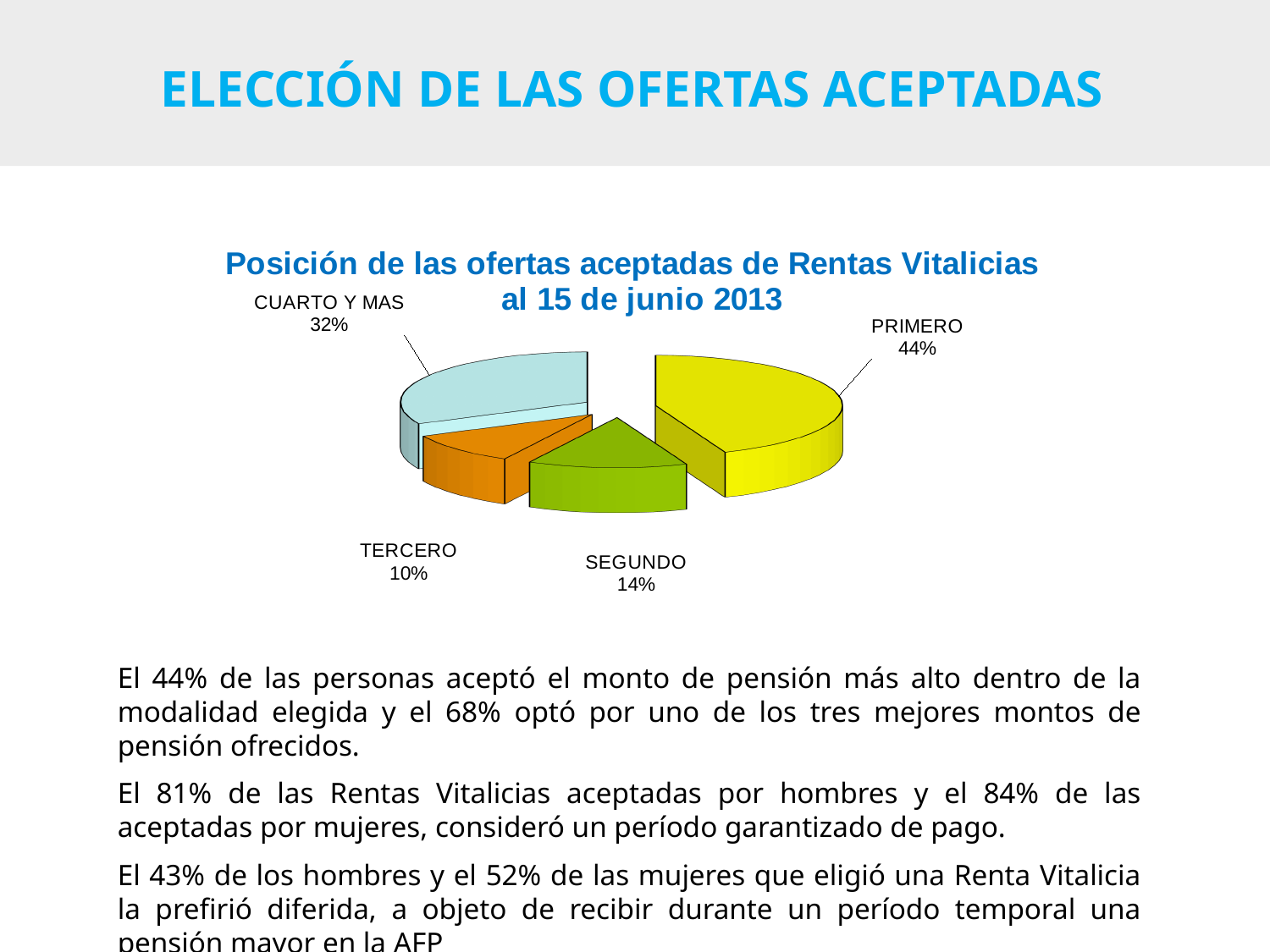
What is the title of the pie chart? Posición de las ofertas aceptadas de Rentas Vitalicias al 15 de junio 2013 What is the share for SEGUNDO in the pie chart? 14% What kind of chart is shown on the slide? pie chart What is the difference in percentage points between PRIMERO and CUARTO Y MAS? 12 Which category has the largest slice of the pie chart? PRIMERO What is the share for TERCERO in the pie chart? 10% How many slices does the pie chart have? 4 What is the share for PRIMERO in the pie chart? 44% What colour is the PRIMERO slice in the pie chart? yellow Which is larger, the share for SEGUNDO or the share for TERCERO? SEGUNDO Which category has the smallest slice of the pie chart? TERCERO What is the share for CUARTO Y MAS in the pie chart? 32%